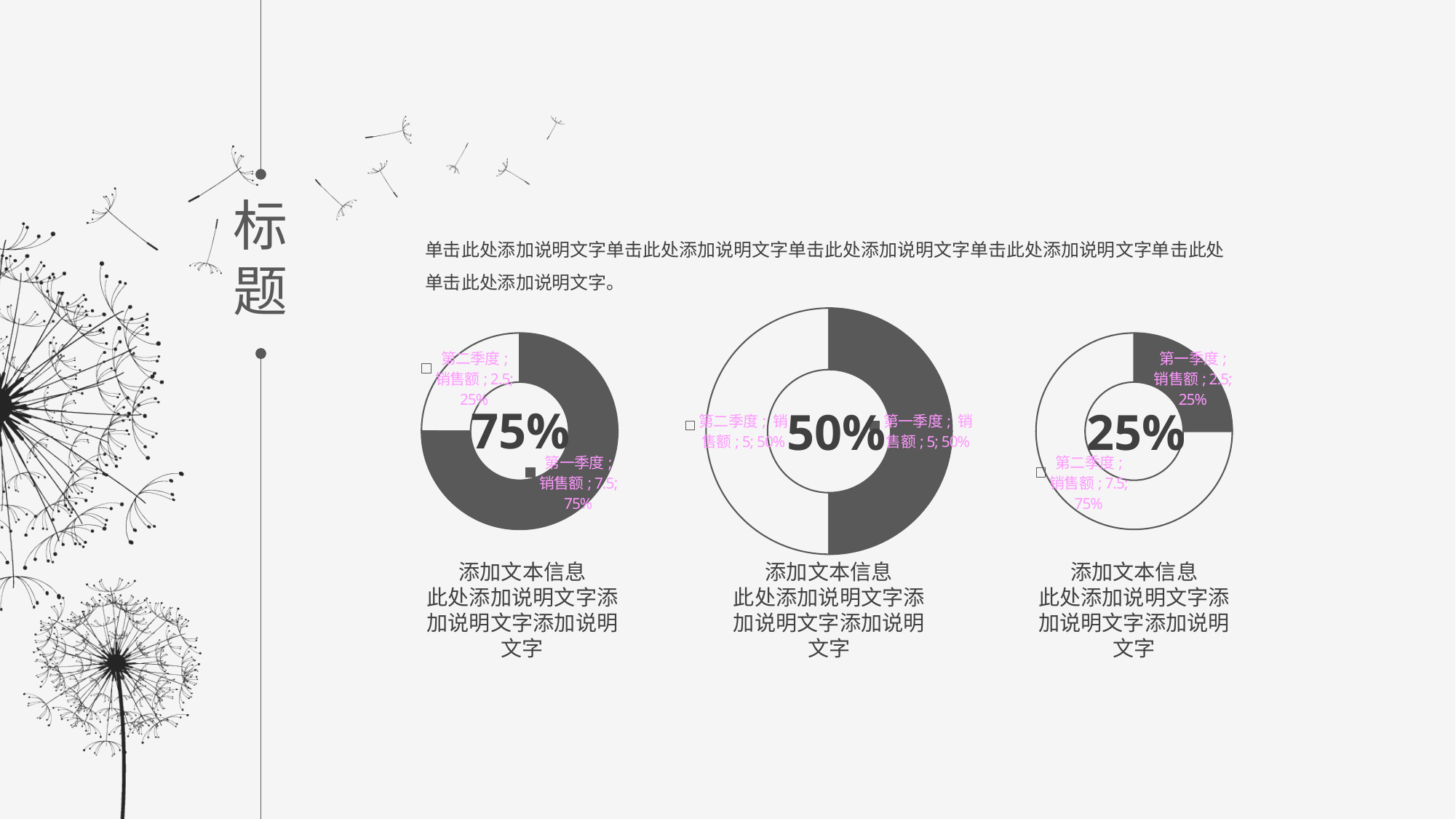
In the middle chart (50%), what share does 第一季度 take? 50% In the middle chart (50%), what is the 销售额 value for 第二季度? 5 In the right chart (25%), what share does 第一季度 take? 25% In the left chart (75%), what is the difference in 销售额 between 第一季度 and 第二季度? 5 In the left chart (75%), which category has the larger 销售额, 第一季度 or 第二季度? 第一季度 In the left chart (75%), what share of the doughnut does 第二季度 take? 25% In the right chart (25%), which category has the smallest 销售额? 第一季度 In the right chart (25%), what is the 销售额 value for 第二季度? 7.5 In the left chart (75%), what is the 销售额 value for 第一季度? 7.5 What kind of chart is the left chart showing 75%? doughnut chart How many doughnut charts are on the slide? 3 How many categories are shown in the middle chart (50%)? 2